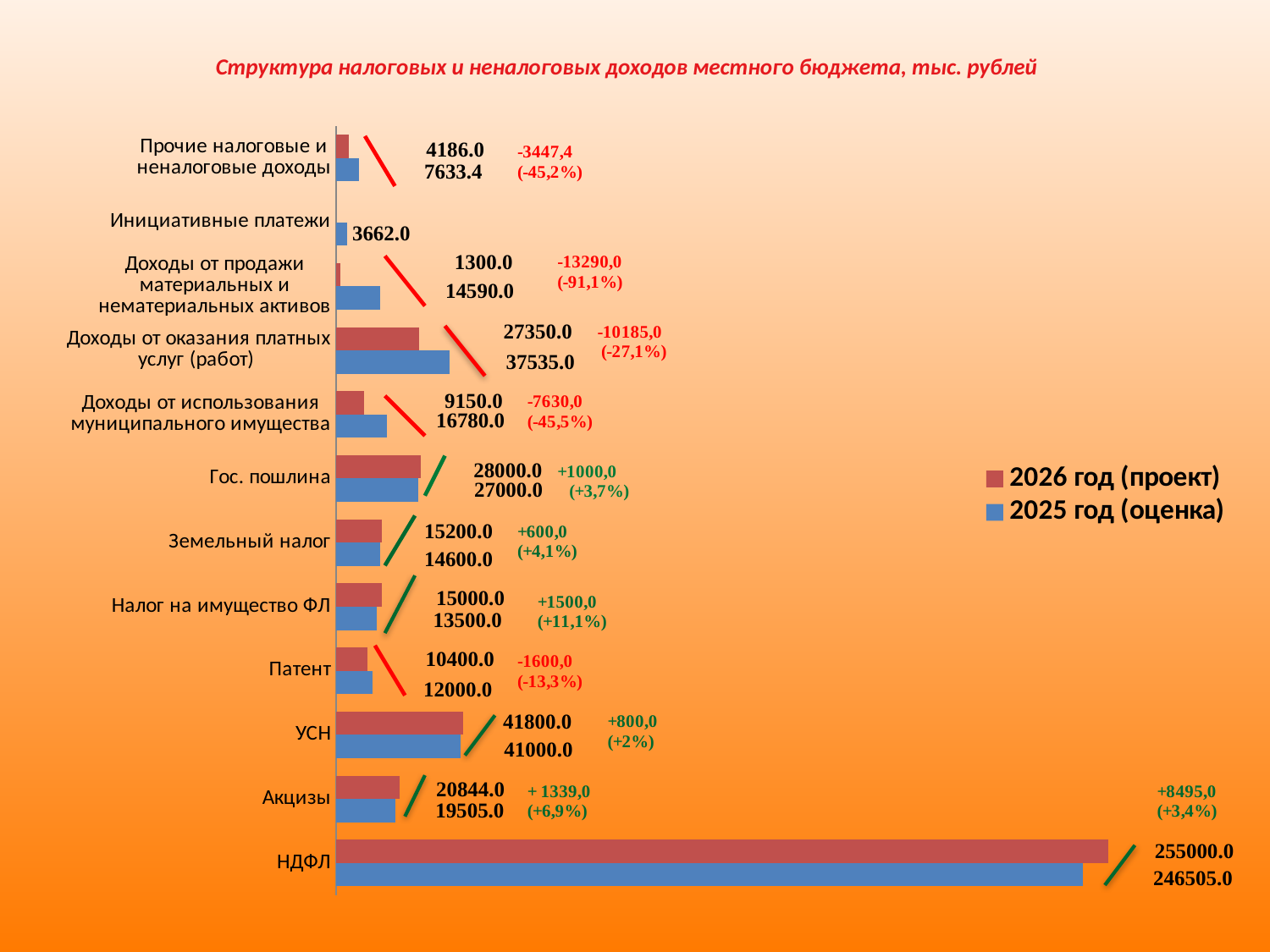
What is the value for НДФЛ in the 2026 год (проект) series? 255000.0 Which colour represents the 2025 год (оценка) series? blue How many series does the legend list? 2 Which category has the lowest value in the 2026 год (проект) series? Доходы от продажи материальных и нематериальных активов What is the title of the chart? Структура налоговых и неналоговых доходов местного бюджета, тыс. рублей What is the value for Инициативные платежи in the 2025 год (оценка) series? 3662.0 Which is larger for Патент: the 2026 год (проект) value or the 2025 год (оценка) value? 2025 год (оценка) Which category has the highest value in the 2026 год (проект) series? НДФЛ What is the value for УСН in the 2025 год (оценка) series? 41000.0 How many categories are shown on the chart? 12 What type of chart is shown on the slide? bar chart What is the difference between the 2026 год (проект) and 2025 год (оценка) values for Гос. пошлина? 1000.0